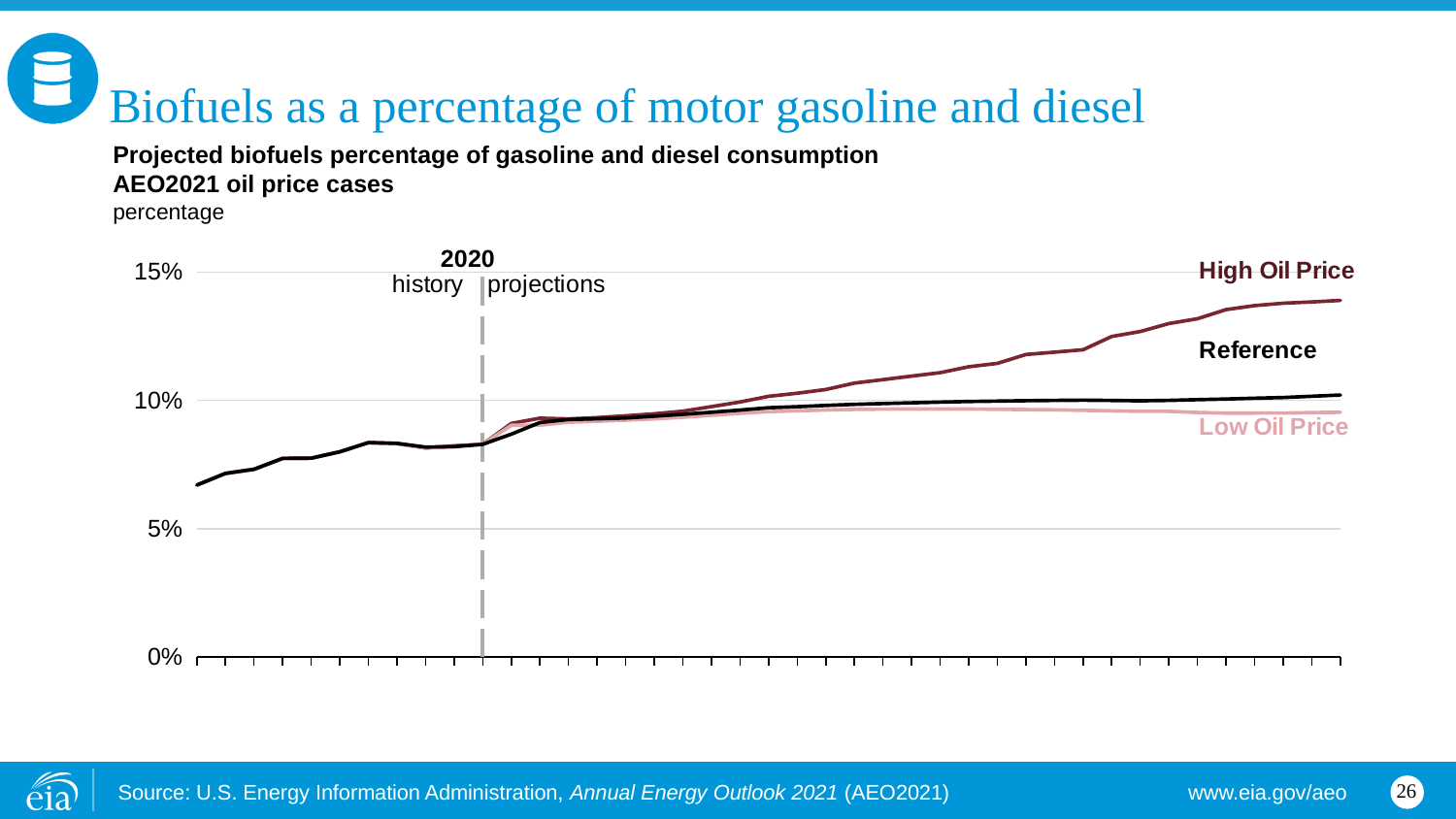
Which series has the highest value at the end of the projection period? High Oil Price What kind of chart is shown on the slide? line chart What is the unit shown on the vertical axis of the chart? percentage Which year separates history from projections on the chart? 2020 How many series are plotted on the chart? 3 Which is larger at the end of the projection period, the Reference case or the Low Oil Price case? Reference Does the High Oil Price series rise or fall over the projection period? rise At the end of the projection period, is the value for High Oil Price greater or less than 10%? greater Which series has the lowest value at the end of the projection period? Low Oil Price At the end of the projection period, is the value for Low Oil Price greater or less than 10%? less At the start of the history period, is the biofuels percentage greater or less than 5%? greater